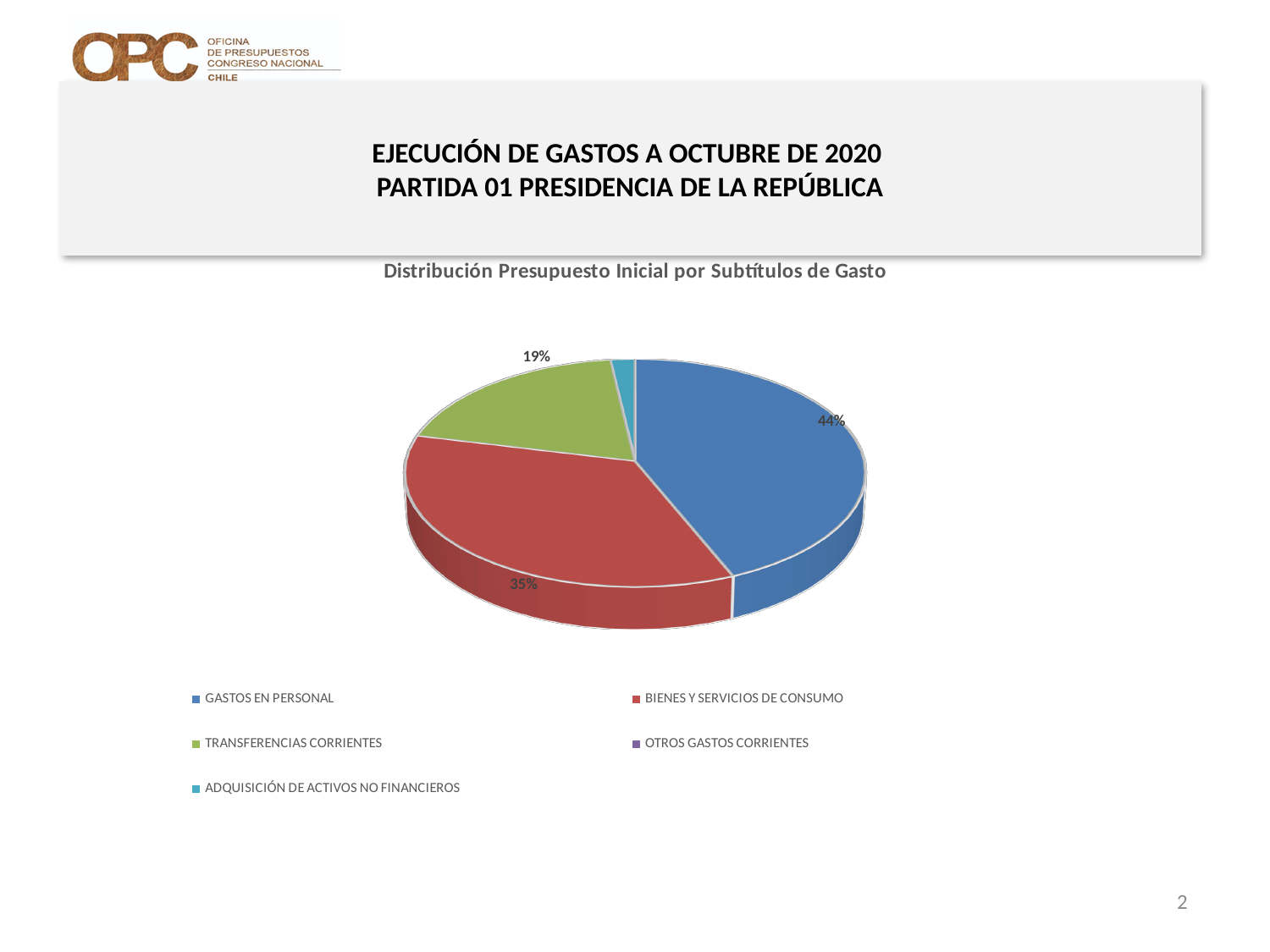
What kind of chart is shown on the slide? Pie chart What is the title of the chart? Distribución Presupuesto Inicial por Subtítulos de Gasto What is the difference in percentage points between GASTOS EN PERSONAL and BIENES Y SERVICIOS DE CONSUMO? 9 percentage points What share of the pie does GASTOS EN PERSONAL represent? 44% Which is larger, the slice for BIENES Y SERVICIOS DE CONSUMO or the slice for TRANSFERENCIAS CORRIENTES? BIENES Y SERVICIOS DE CONSUMO What colour is the slice for TRANSFERENCIAS CORRIENTES? Green Which category has the largest slice of the pie? GASTOS EN PERSONAL What share of the pie does TRANSFERENCIAS CORRIENTES represent? 19% What is the difference in percentage points between BIENES Y SERVICIOS DE CONSUMO and TRANSFERENCIAS CORRIENTES? 16 percentage points How many categories does the legend list? 5 What share of the pie does BIENES Y SERVICIOS DE CONSUMO represent? 35% Which is larger, the slice for GASTOS EN PERSONAL or the slice for ADQUISICIÓN DE ACTIVOS NO FINANCIEROS? GASTOS EN PERSONAL